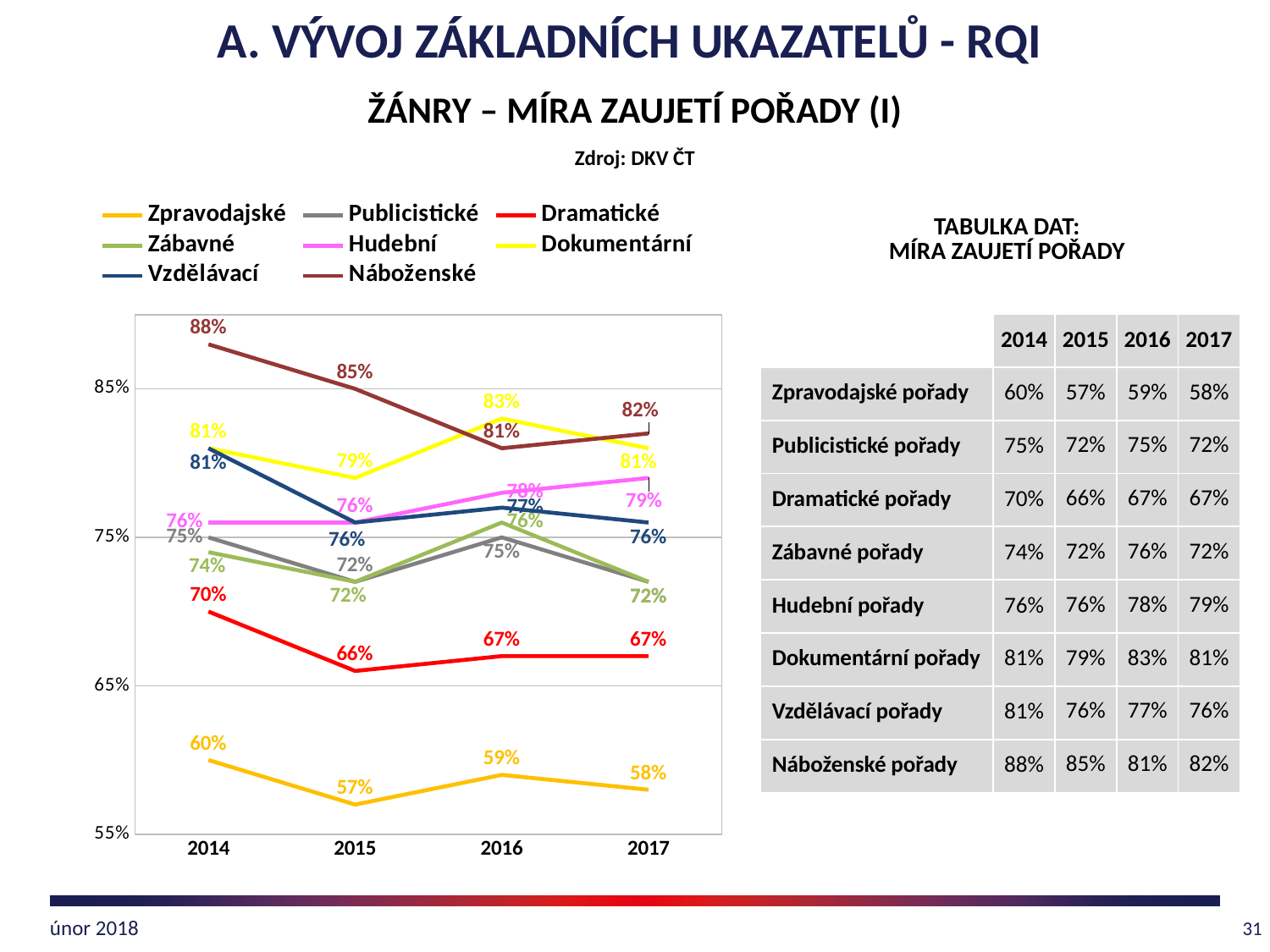
Is the value for Dramatické in 2015 greater or less than 65%? greater What kind of chart is shown on the slide? line chart How many years are plotted along the x axis of the chart? 4 What is the value for Náboženské in 2014? 88% Which series has the highest value in 2014? Náboženské Does the Náboženské line rise or fall from 2014 to 2016? fall By how many percentage points did the Náboženské value fall from 2014 to 2017? 6 percentage points What is the value for Zpravodajské in 2015? 57% How many series does the chart legend list? 8 Which series has the lowest value in 2017? Zpravodajské In 2016, which is higher: Dokumentární or Náboženské? Dokumentární What colour is the Dramatické line in the chart? red